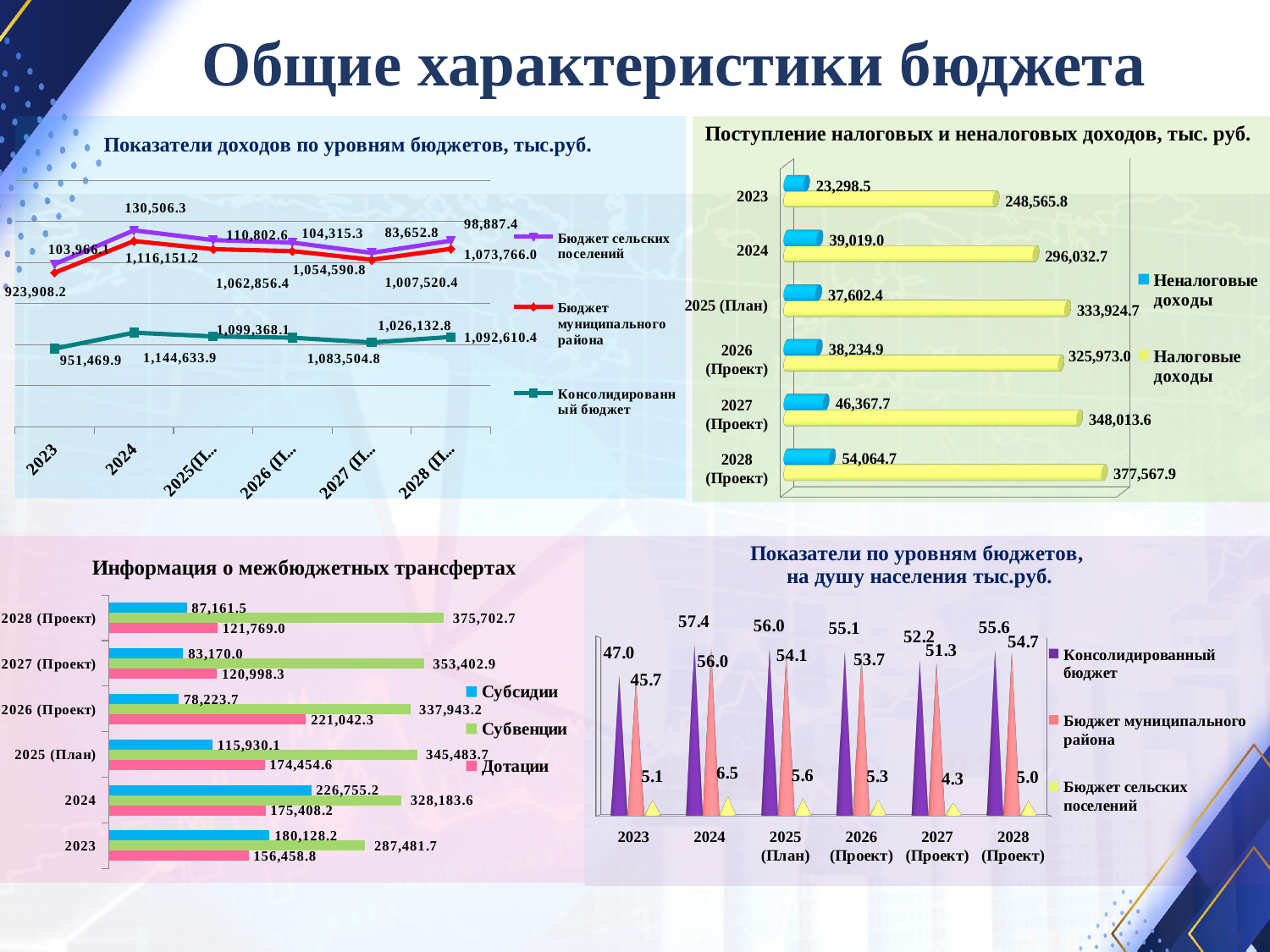
In the chart 'Показатели по уровням бюджетов, на душу населения тыс.руб.', how many years are shown on the x axis? 6 In the chart 'Информация о межбюджетных трансфертах', what is the difference between Субвенции and Дотации for 2028 (Проект)? 253,933.7 In the chart 'Поступление налоговых и неналоговых доходов, тыс. руб.', what is the value of Налоговые доходы for 2028 (Проект)? 377,567.9 In the chart 'Показатели доходов по уровням бюджетов, тыс.руб.', what is the value of Бюджет сельских поселений for 2024? 130,506.3 What kind of chart is 'Показатели доходов по уровням бюджетов, тыс.руб.'? Line chart In the chart 'Показатели по уровням бюджетов, на душу населения тыс.руб.', what is the value of Консолидированный бюджет for 2024? 57.4 In the chart 'Показатели доходов по уровням бюджетов, тыс.руб.', which series is shown in red? Бюджет муниципального района In the chart 'Поступление налоговых и неналоговых доходов, тыс. руб.', which year has the lowest value of Неналоговые доходы? 2023 In the chart 'Показатели по уровням бюджетов, на душу населения тыс.руб.', which year has the lowest value of Бюджет сельских поселений? 2027 (Проект) In the chart 'Поступление налоговых и неналоговых доходов, тыс. руб.', how many series does the legend list? 2 In the chart 'Информация о межбюджетных трансфертах', which year has the highest value of Субсидии? 2024 In the chart 'Информация о межбюджетных трансфертах', what is the value of Субвенции for 2025 (План)? 345,483.7